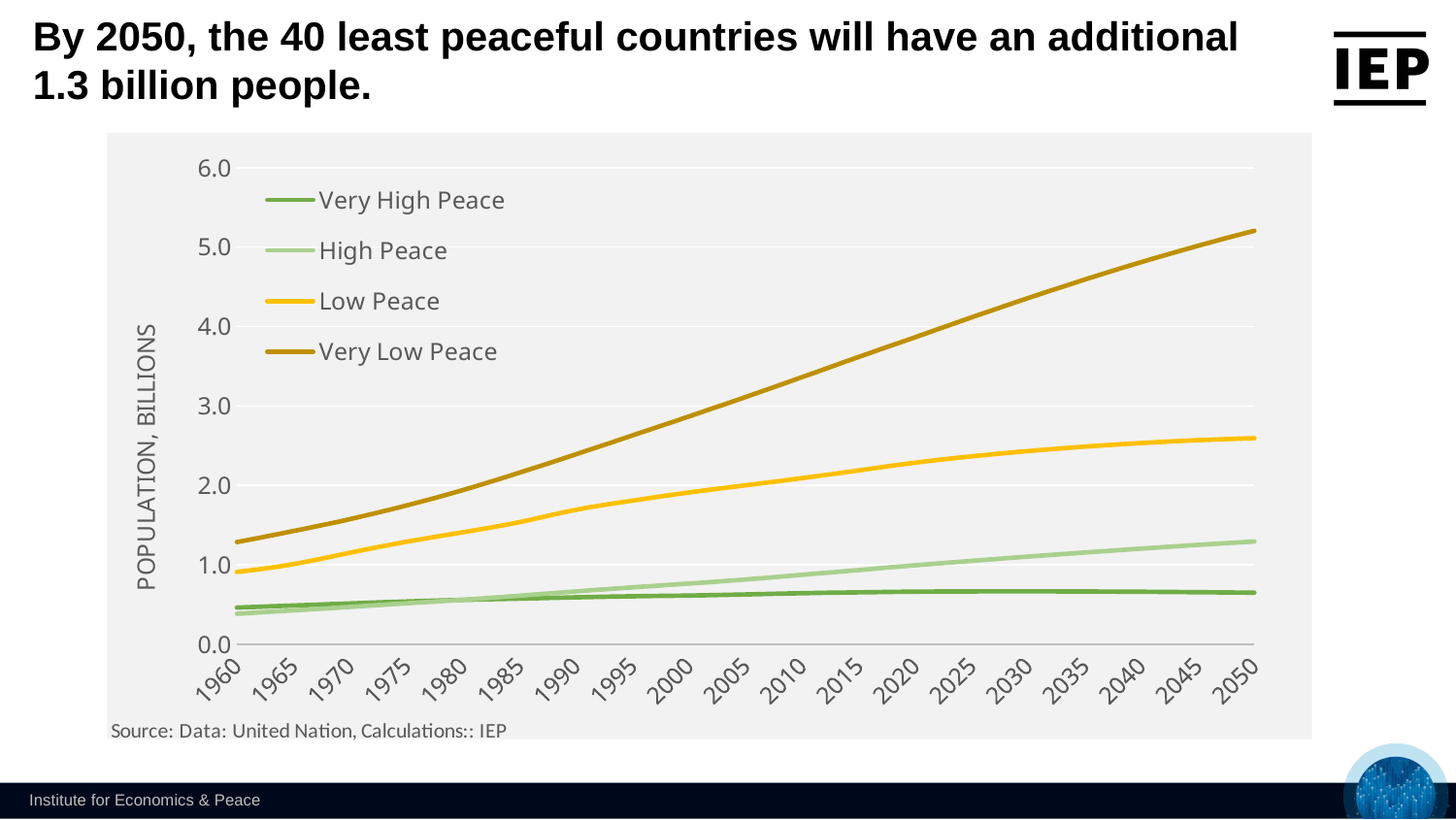
Is the value for Very Low Peace in 2010 greater or less than 3.0? greater Is the value for Very Low Peace in 2050 greater or less than 5.0? greater In 2050, which is larger: the value for High Peace or the value for Very High Peace? High Peace How many series does the legend list? 4 Which series has the lowest population in 2050? Very High Peace How many year labels are shown along the x axis? 19 Does the Very Low Peace line rise or fall from 1960 to 2050? Rises What kind of chart is shown on the slide? Line chart What is the label on the y axis? POPULATION, BILLIONS Is the value for Low Peace in 2050 greater or less than 2.0? greater Which series has the highest population in 2050? Very Low Peace